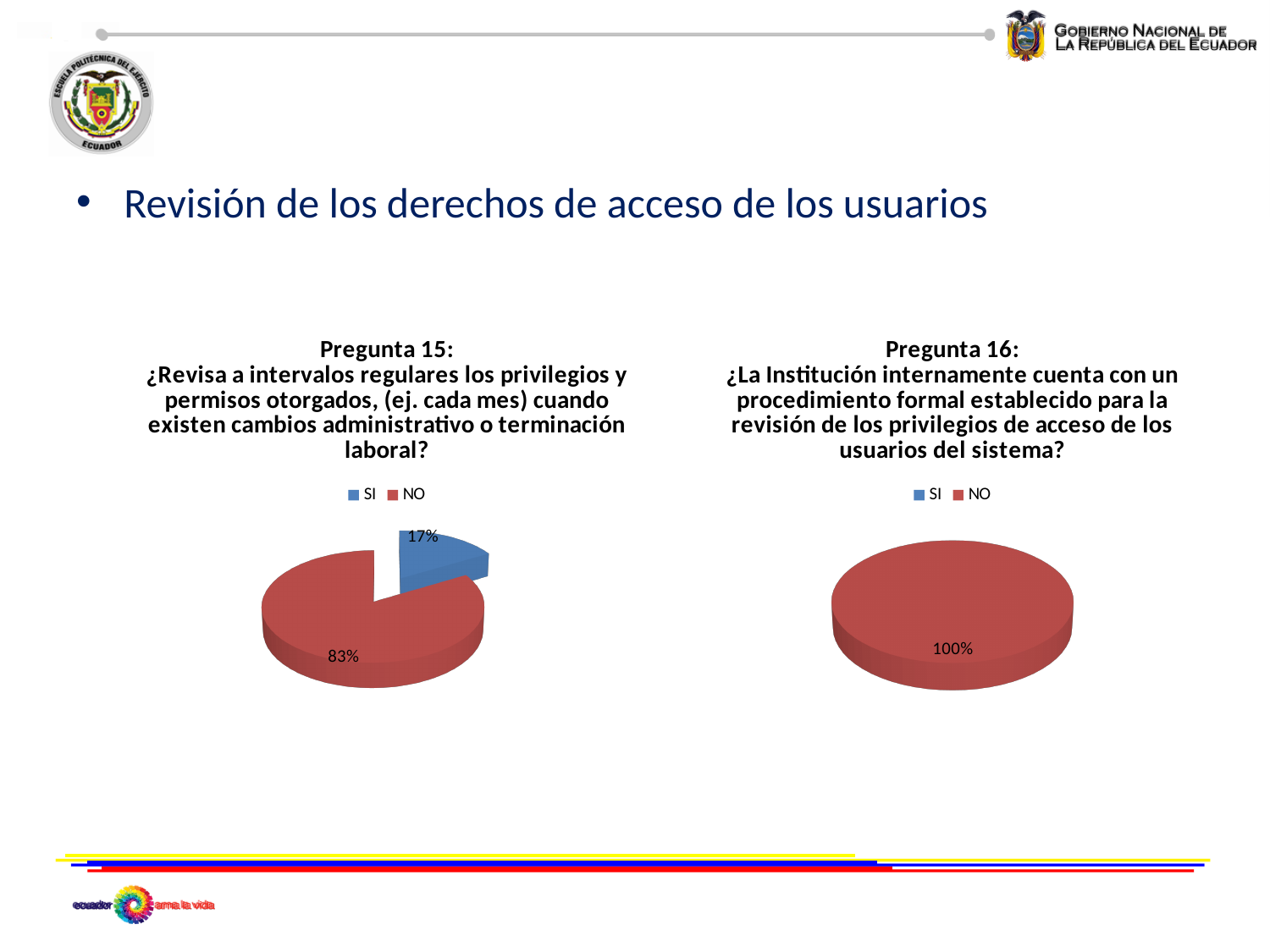
How many entries does the legend of the Pregunta 15 chart list? 2 How many charts are shown on the slide? 2 In the Pregunta 15 chart, which response has the largest share? NO In the Pregunta 15 chart, what percentage is shown for SI? 17% What kind of chart is the Pregunta 16 chart? Pie chart In the Pregunta 16 chart, what share of the pie does NO take? 100% In the Pregunta 15 chart, which response has the smallest share? SI In the Pregunta 16 chart, what percentage is shown for NO? 100% In the Pregunta 15 chart, what percentage is shown for NO? 83% In the Pregunta 15 chart, which is larger, SI or NO? NO In the Pregunta 15 chart, what colour represents NO? Red In the Pregunta 15 chart, what is the difference in percentage points between NO and SI? 66